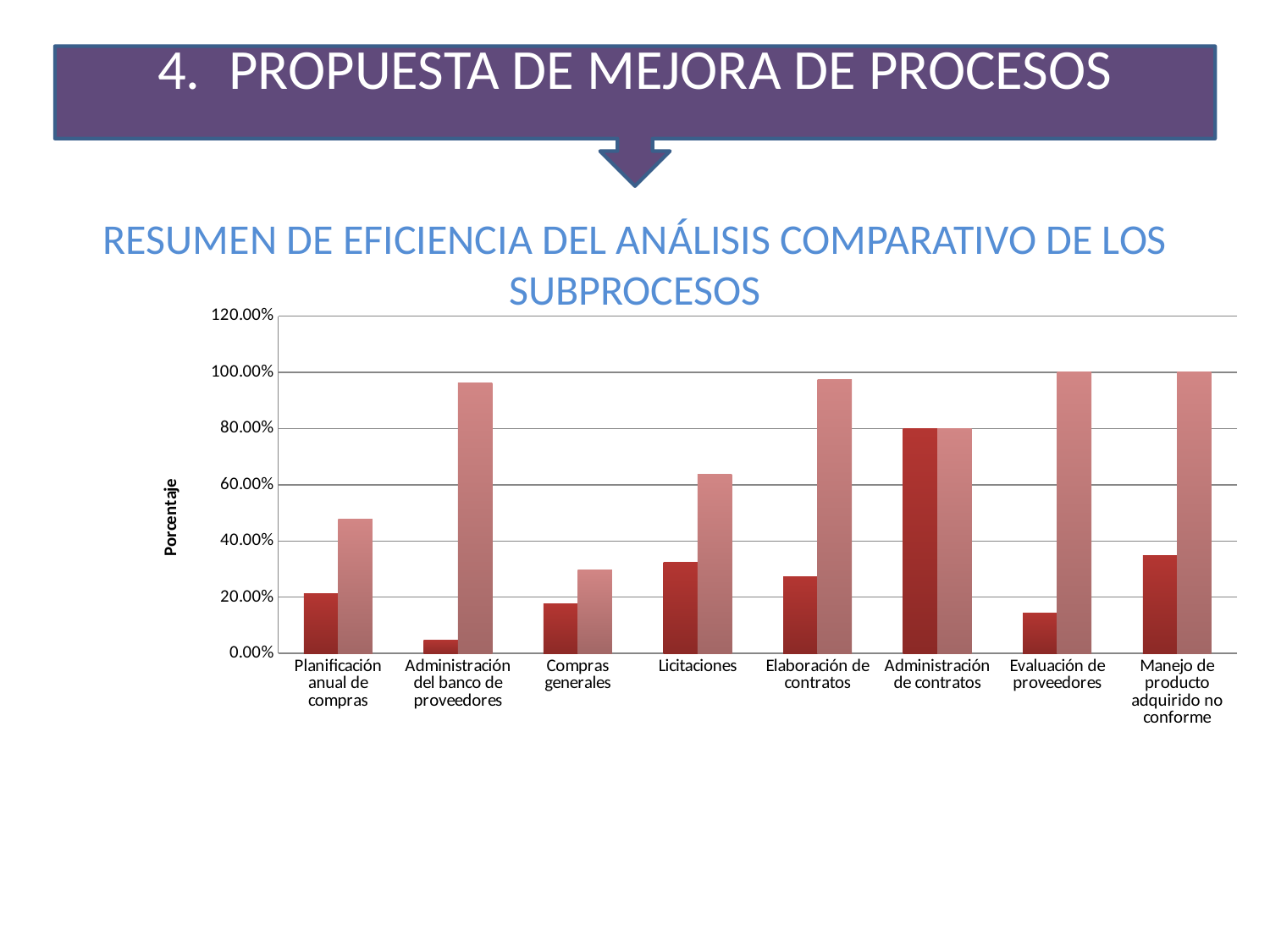
Is the dark red bar for Evaluación de proveedores greater or less than 20.00%? less What is the title of the chart? RESUMEN DE EFICIENCIA DEL ANÁLISIS COMPARATIVO DE LOS SUBPROCESOS Is the dark red bar for Compras generales greater or less than 20.00%? less Which is larger for Licitaciones, the dark red bar or the light red bar? the light red bar Is the light red bar for Planificación anual de compras greater or less than 60.00%? less What kind of chart is shown on the slide? bar chart Which category has the highest dark red bar? Administración de contratos What is the label of the vertical axis of the chart? Porcentaje Which category has the lowest light red bar? Compras generales How many subprocess categories are shown on the x axis of the chart? 8 Which category has the lowest dark red bar? Administración del banco de proveedores